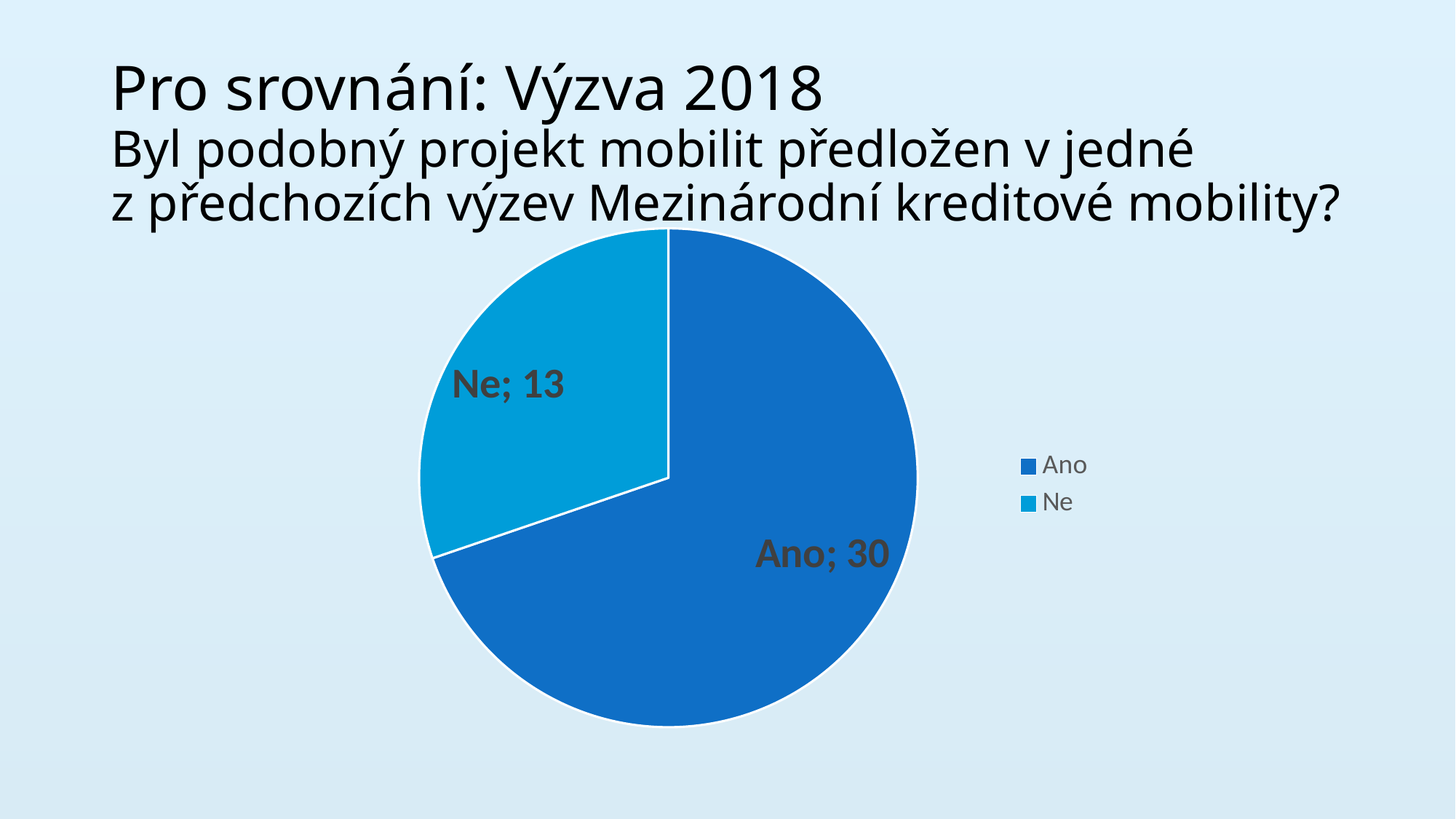
Which category is shown in the lighter blue colour? Ne What is the total of all slices in the pie chart? 43 Which entries does the legend list? Ano, Ne Which category has the smallest slice of the pie? Ne How many categories does the pie chart show? 2 What is the value for Ano? 30 Which is larger, the value for Ano or the value for Ne? Ano What is the difference between the values for Ano and Ne? 17 What kind of chart is shown on the slide? pie chart Which category has the largest slice of the pie? Ano What is the value for Ne? 13